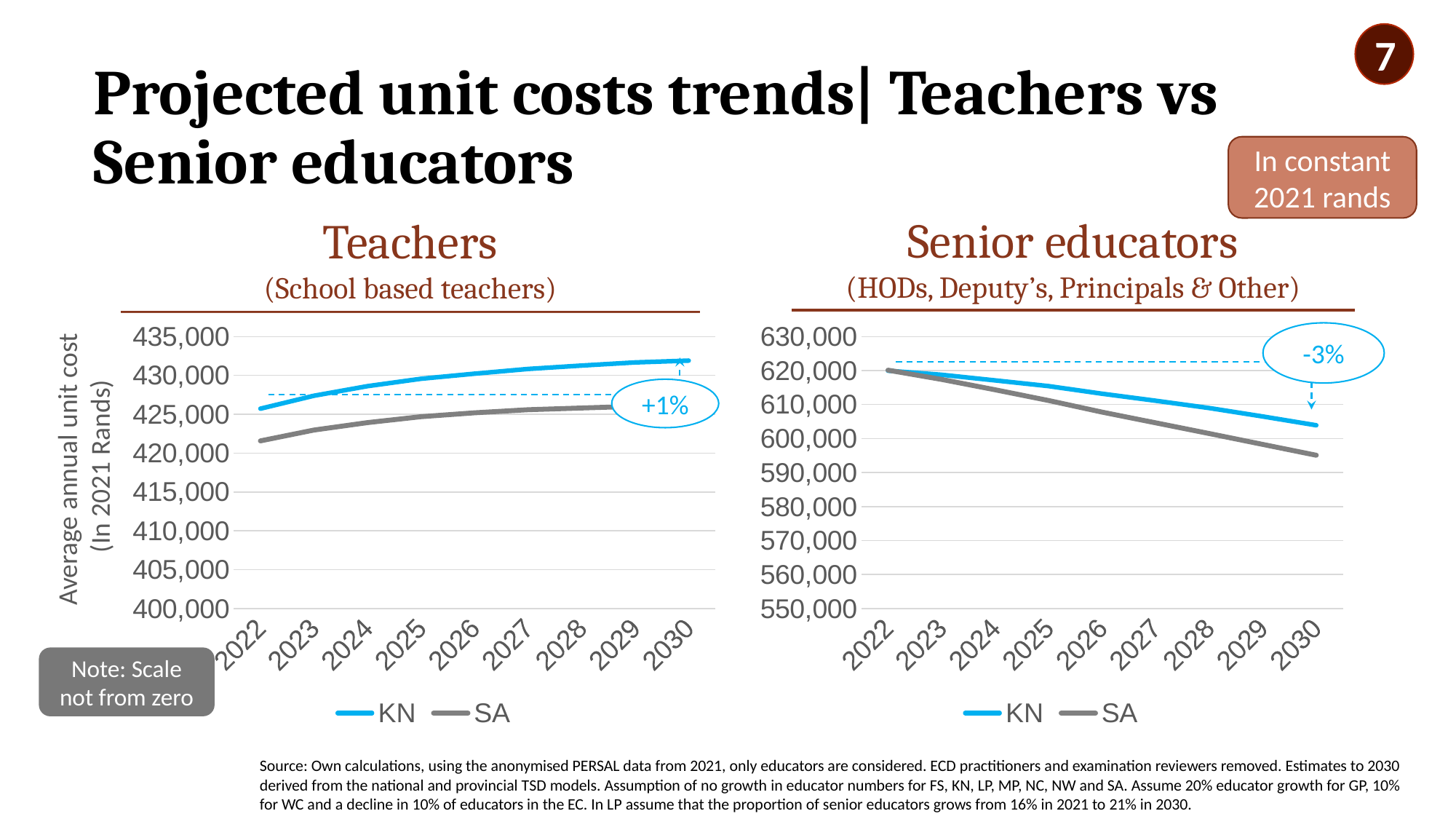
In the Senior educators chart, is the value for KN in 2030 greater or less than 600,000? greater What kind of chart is the Teachers chart? line chart In the Senior educators chart, is the value for SA in 2030 greater or less than 600,000? less How many years are shown on the x axis of the Teachers chart? 9 In the Senior educators chart, does the SA line rise or fall from 2022 to 2030? fall In the Senior educators chart, which series has the higher value in 2030, KN or SA? KN How many series does the legend of the Senior educators chart list? 2 What percentage change is annotated on the Senior educators chart? -3% In the Teachers chart, does the KN line rise or fall from 2022 to 2030? rise In the Teachers chart, is the value for KN in 2030 greater or less than 430,000? greater In the Teachers chart, which series has the higher value in 2030, KN or SA? KN